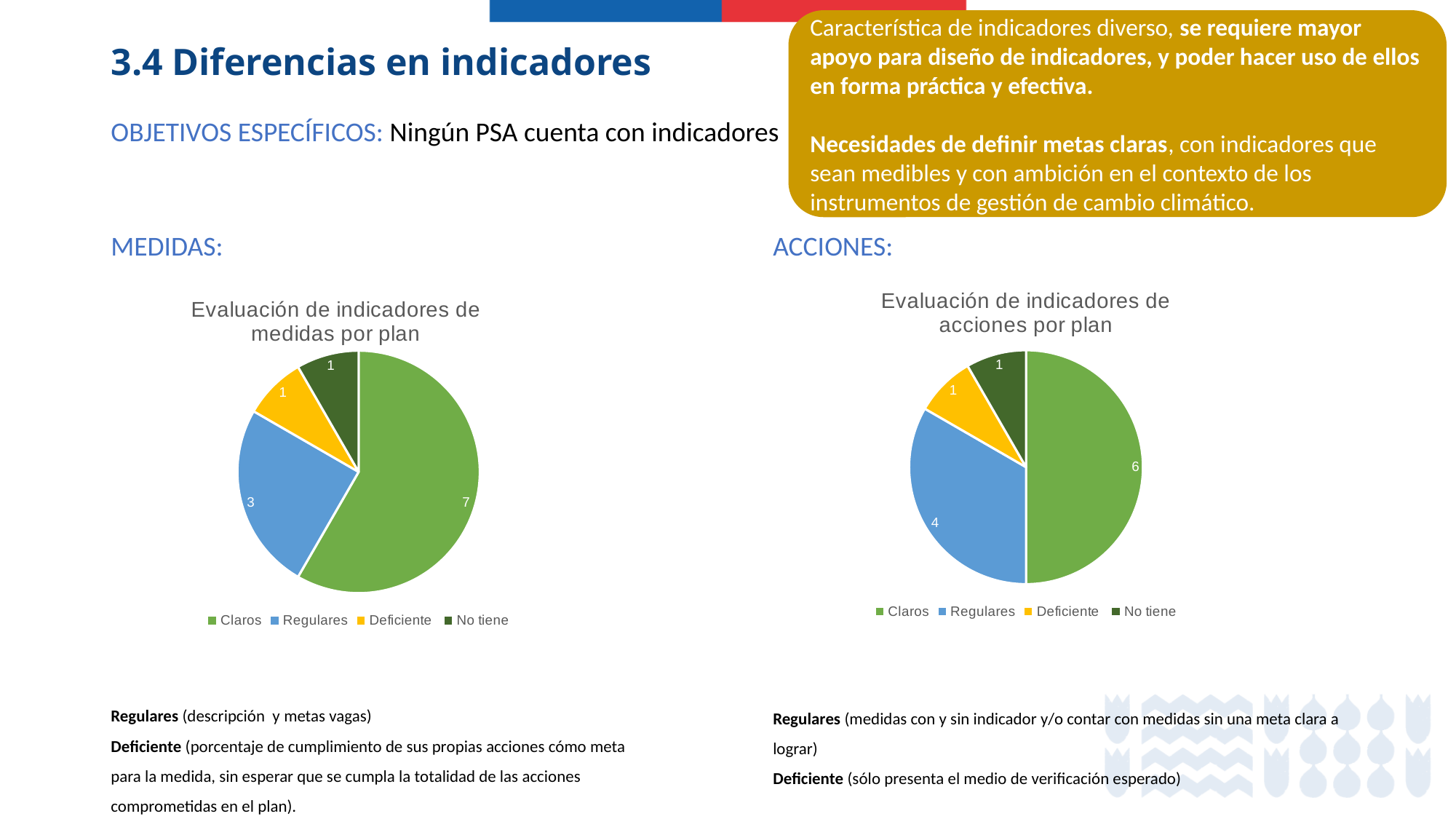
In the chart titled 'Evaluación de indicadores de acciones por plan', what is the difference between the values for Claros and Regulares? 2 In the chart titled 'Evaluación de indicadores de acciones por plan', what is the value for Regulares? 4 In the chart titled 'Evaluación de indicadores de medidas por plan', what is the difference between the values for Claros and Regulares? 4 In the chart titled 'Evaluación de indicadores de acciones por plan', which category has the largest slice? Claros How many categories does the legend of the chart titled 'Evaluación de indicadores de medidas por plan' list? 4 In the chart titled 'Evaluación de indicadores de medidas por plan', which category has the largest slice? Claros In the chart titled 'Evaluación de indicadores de medidas por plan', what is the value for Claros? 7 In the chart titled 'Evaluación de indicadores de acciones por plan', what is the value for Claros? 6 What type of chart is 'Evaluación de indicadores de acciones por plan'? Pie chart Which chart has the larger value for Regulares: 'Evaluación de indicadores de medidas por plan' or 'Evaluación de indicadores de acciones por plan'? Evaluación de indicadores de acciones por plan In the chart titled 'Evaluación de indicadores de medidas por plan', what is the value for Regulares? 3 In the chart titled 'Evaluación de indicadores de acciones por plan', what share of the total does Claros represent? 50%